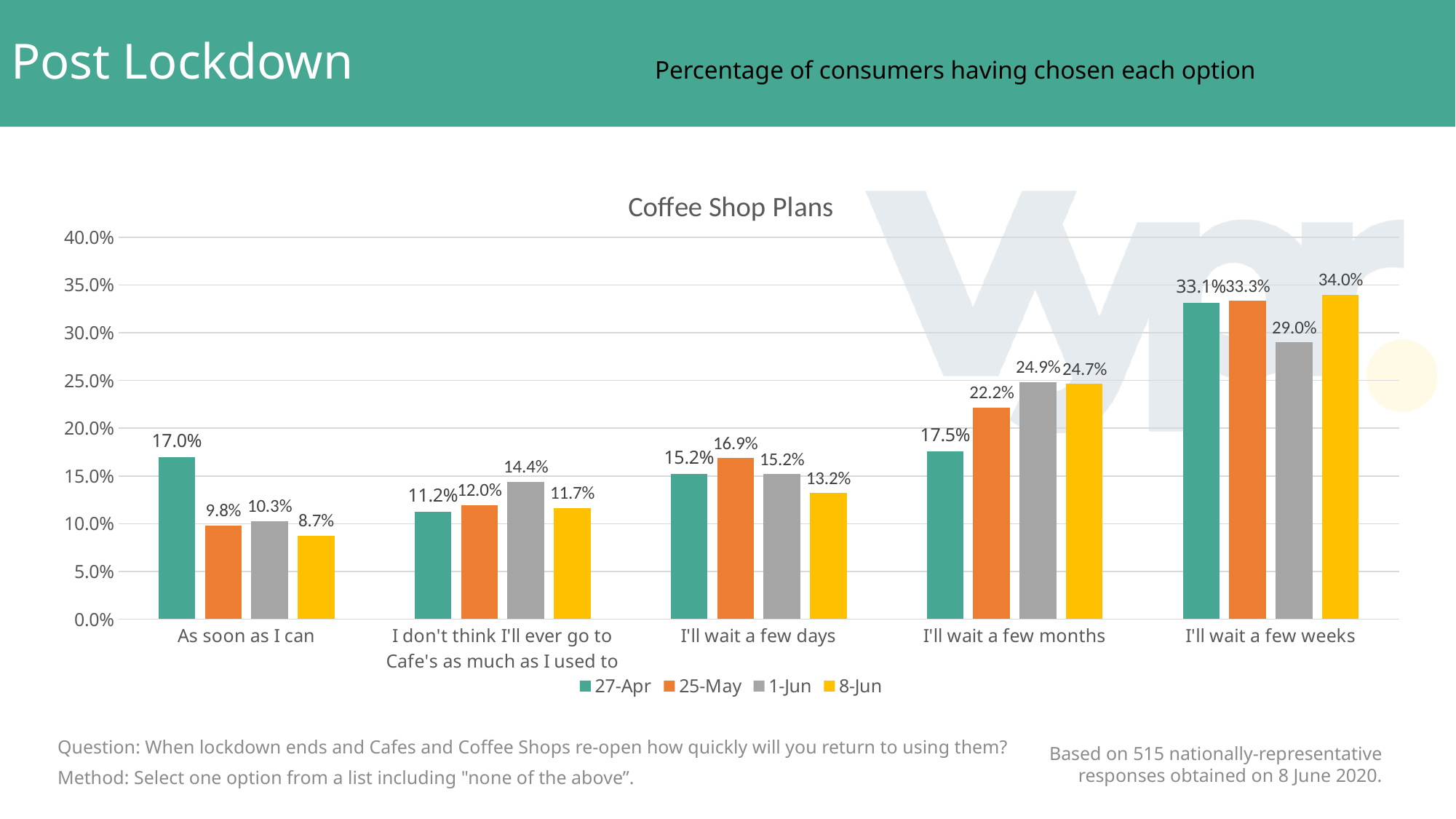
What is the title of the chart? Coffee Shop Plans How many categories are shown on the x axis? 5 What is the difference between the 8-Jun and 1-Jun values for 'I'll wait a few weeks'? 5.0% What is the value for 'I'll wait a few months' in the 1-Jun series? 24.9% Which category has the highest value in the 25-May series? I'll wait a few weeks What is the value for 'I'll wait a few weeks' in the 8-Jun series? 34.0% What kind of chart is shown on the slide? Bar chart What is the value for 'As soon as I can' in the 27-Apr series? 17.0% Which series is shown in orange in the legend? 25-May Which category has the lowest value in the 8-Jun series? As soon as I can How many series does the legend list? 4 Which is larger for 'I'll wait a few days': the 25-May value or the 8-Jun value? 25-May